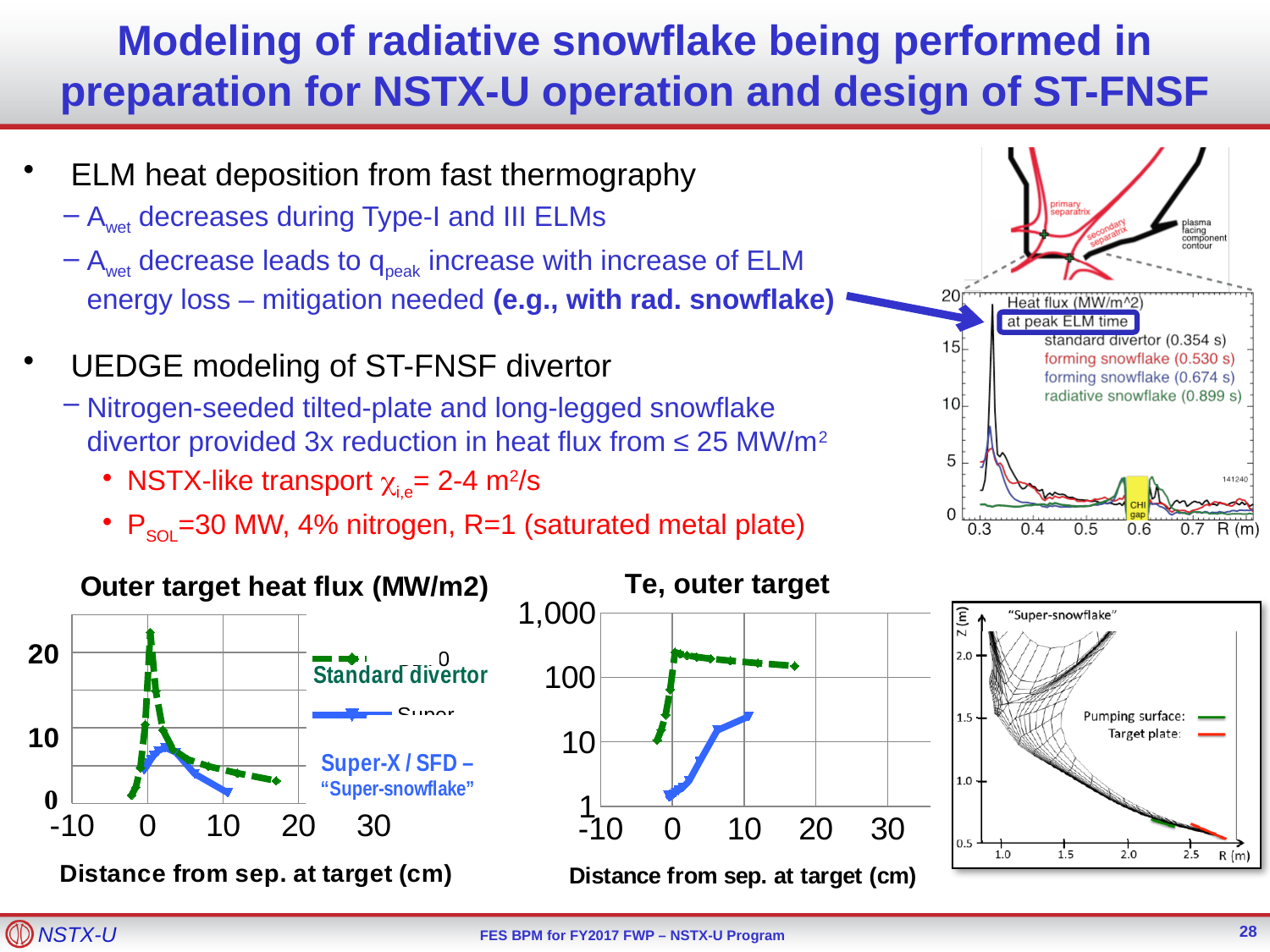
What is the x-axis label of the "Outer target heat flux (MW/m2)" chart? Distance from sep. at target (cm) In the "Te, outer target" chart, which series has the higher Te at 10 cm from the separatrix, the green or the blue one? green In the top-right "Heat flux (MW/m^2) at peak ELM time" chart, which series reaches the highest peak heat flux? standard divertor (0.354 s) In the "Te, outer target" chart, is the peak value of the blue (Super-snowflake) series greater or less than 100? less In the "Outer target heat flux (MW/m2)" chart, is the peak value of the Super-X / SFD "Super-snowflake" series greater or less than 10? less In the top-right "Heat flux (MW/m^2) at peak ELM time" chart, how many series does the legend list? 4 In the "Outer target heat flux (MW/m2)" chart, how many series does the legend list? 2 What kind of chart is the "Te, outer target" chart? line chart What kind of chart is the "Outer target heat flux (MW/m2)" chart? line chart In the "Outer target heat flux (MW/m2)" chart, which series reaches the higher peak heat flux? Standard divertor In the "Outer target heat flux (MW/m2)" chart, is the peak value of the Standard divertor series greater or less than 20? greater